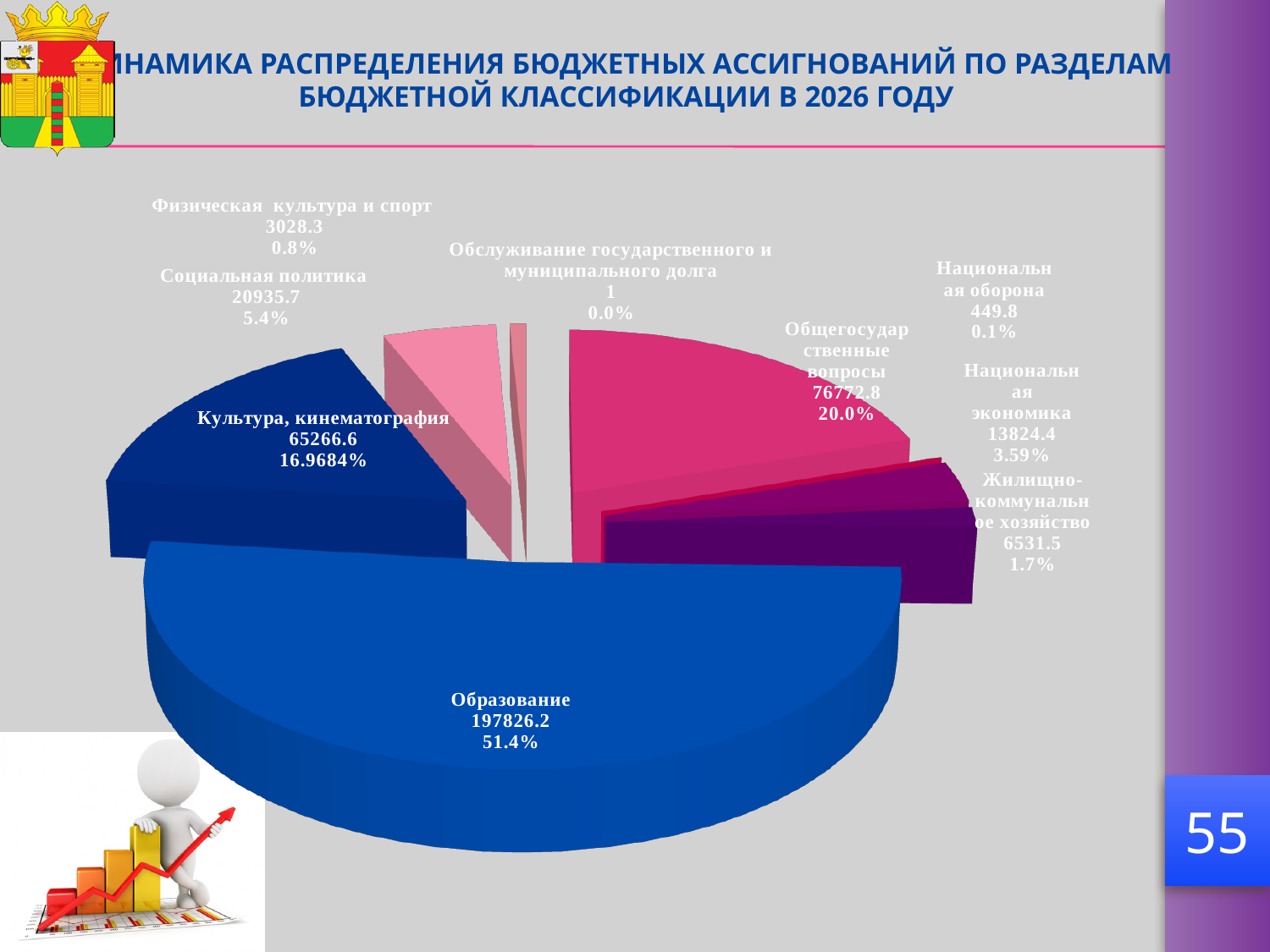
Which category has the largest slice of the pie? Образование Which category has the smallest value in the pie chart? Обслуживание государственного и муниципального долга What is the value shown for Образование? 197826.2 What share of the pie does Образование represent? 51.4% What percentage is shown for Культура, кинематография? 16.9684% How many categories are shown in the pie chart? 9 Which is larger, the value for Национальная экономика or the value for Жилищно-коммунальное хозяйство? Национальная экономика What kind of chart is shown on the slide? pie chart What is the value shown for Общегосударственные вопросы? 76772.8 What is the value shown for Социальная политика? 20935.7 What is the difference between the values for Образование and Общегосударственные вопросы? 121053.4 What percentage is shown for Национальная оборона? 0.1%